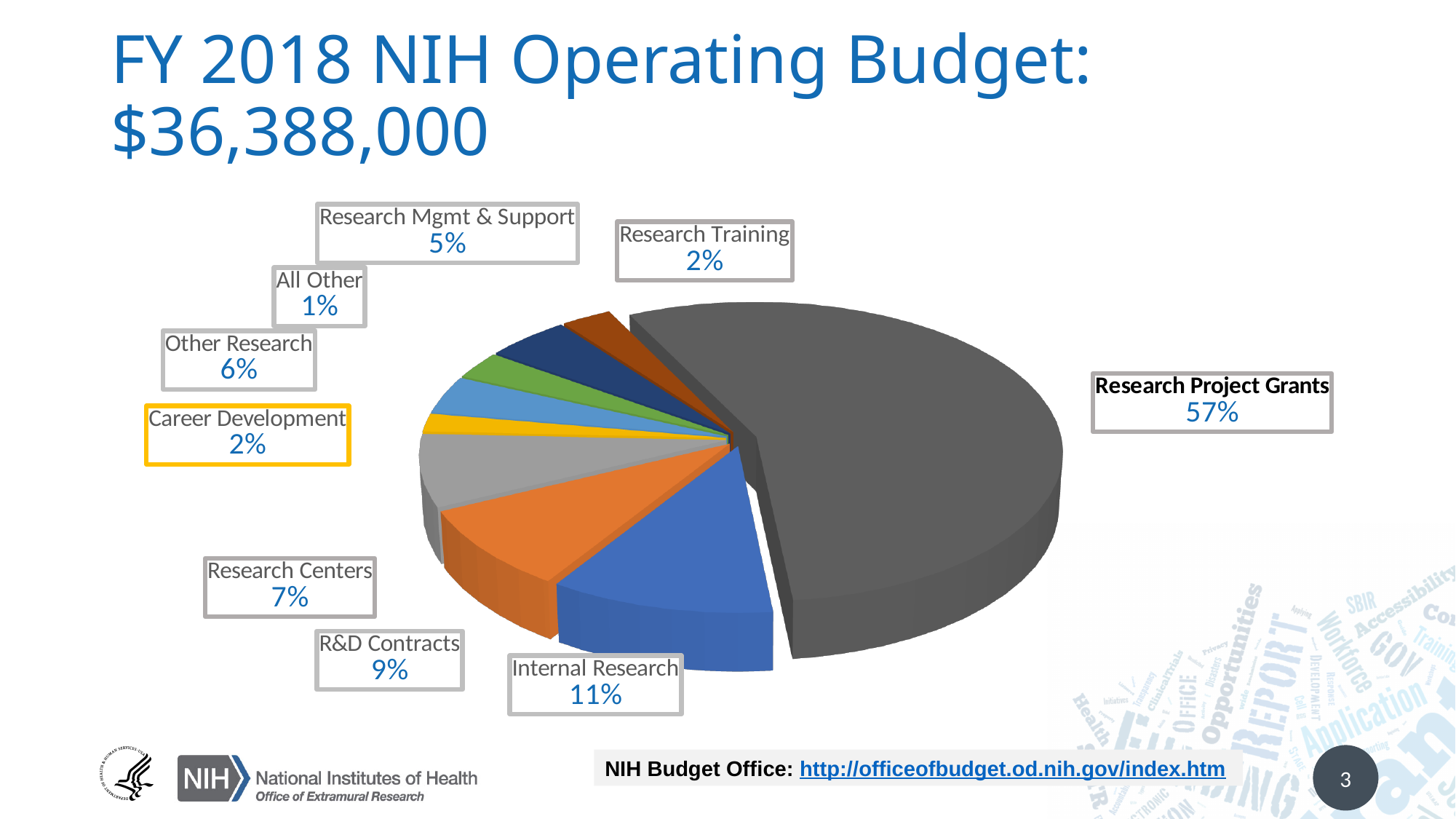
What kind of chart is shown on the slide? pie chart What is the difference in percentage points between Research Project Grants and Internal Research? 46 How many categories are shown in the pie chart? 9 What percentage of the budget is allocated to R&D Contracts? 9% What percentage of the budget is allocated to Internal Research? 11% Which is larger, the share for Research Centers or the share for Other Research? Research Centers Which category has the largest share of the budget? Research Project Grants Which category has the smallest share of the budget? All Other What share of the FY 2018 NIH operating budget goes to Research Project Grants? 57% What is the combined share of Research Training and Career Development? 4% What is the total FY 2018 NIH operating budget stated in the slide title? $36,388,000 What percentage of the budget goes to Research Mgmt & Support? 5%